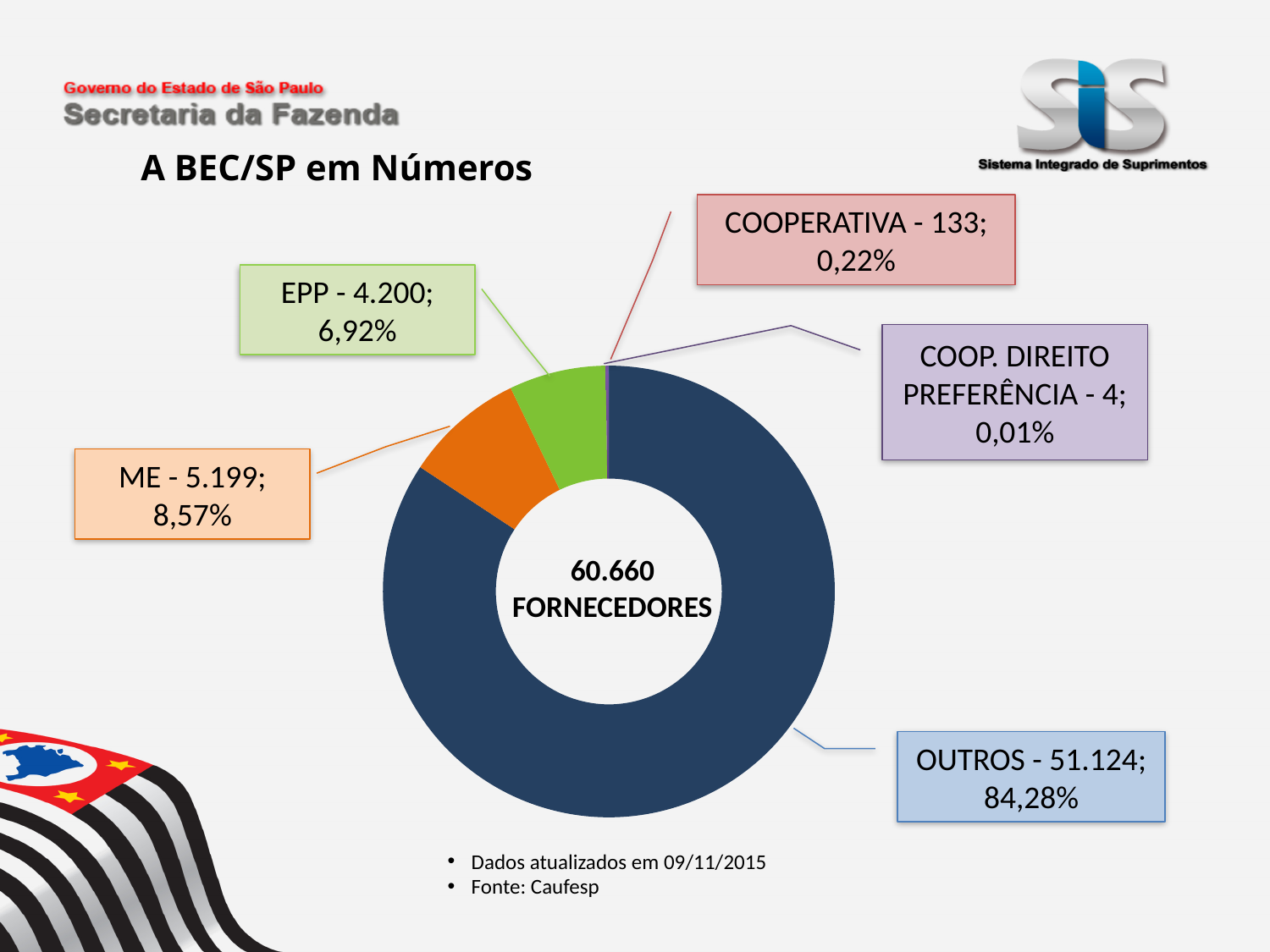
What colour is the OUTROS segment of the chart? Dark blue What total number of suppliers (fornecedores) is shown in the centre of the chart? 60.660 What is the value for OUTROS? 51.124 What is the value for EPP? 4.200 What share of the chart does ME represent? 8,57% How many categories does the chart show? 5 What is the difference between the values for ME and EPP? 999 Which category has the smallest value? COOP. DIREITO PREFERÊNCIA Which category has the largest value? OUTROS What kind of chart is shown on the slide? Doughnut (pie) chart Which is larger, ME or EPP? ME What share of the chart does COOPERATIVA represent? 0,22%